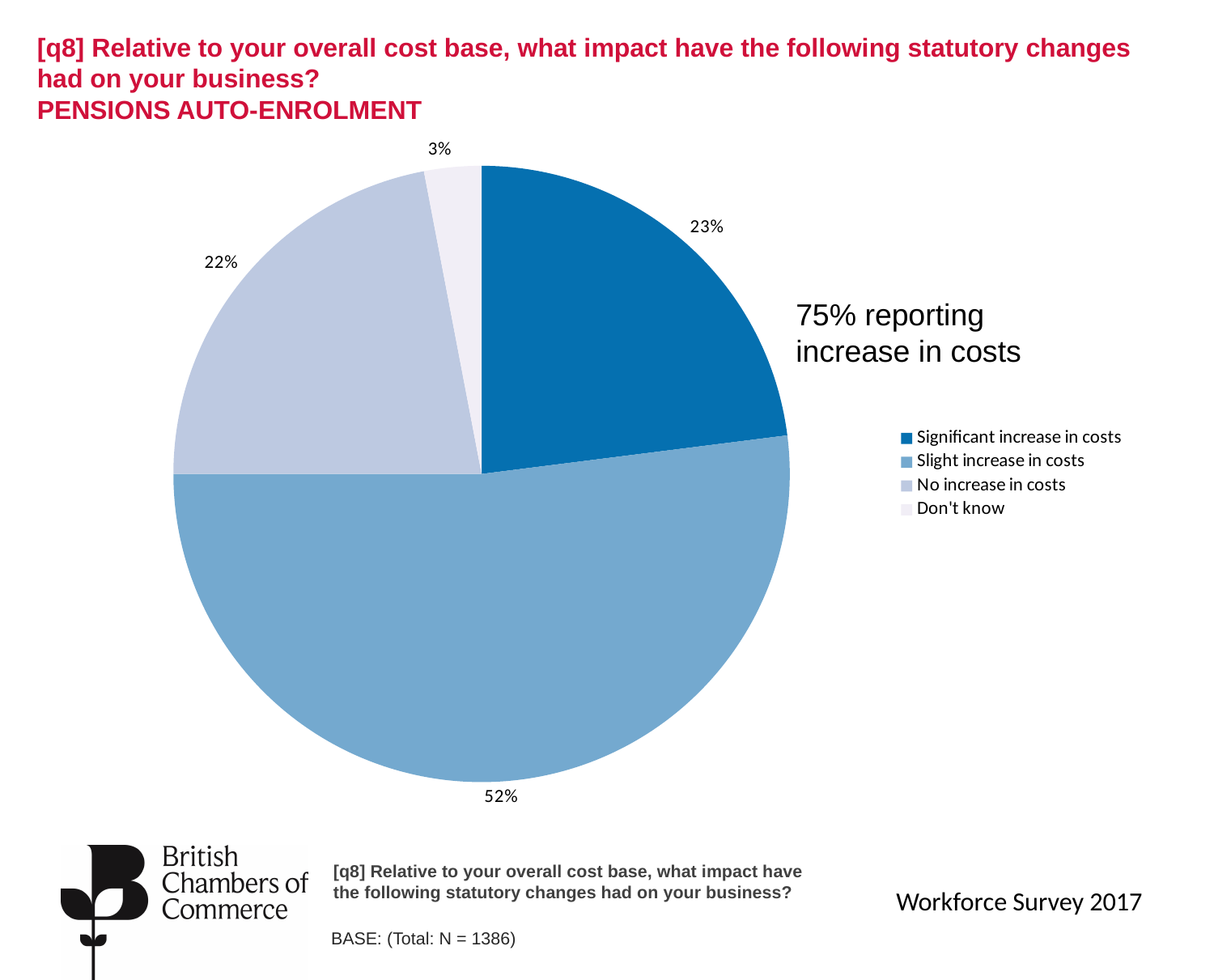
What is the difference in percentage points between 'Slight increase in costs' and 'Significant increase in costs'? 29 What percentage of respondents reported a slight increase in costs? 52% Which is larger: the share for 'Significant increase in costs' or the share for 'No increase in costs'? Significant increase in costs What kind of chart is shown on the slide? pie chart Which response category has the largest share of the pie? Slight increase in costs What is the base sample size (N) stated on the slide? 1386 Which response category has the smallest share of the pie? Don't know What percentage of respondents reported no increase in costs? 22% How many categories does the legend list? 4 What is the combined share of 'Significant increase in costs' and 'Slight increase in costs'? 75% What percentage of respondents reported a significant increase in costs from pensions auto-enrolment? 23% What percentage of respondents answered 'Don't know'? 3%